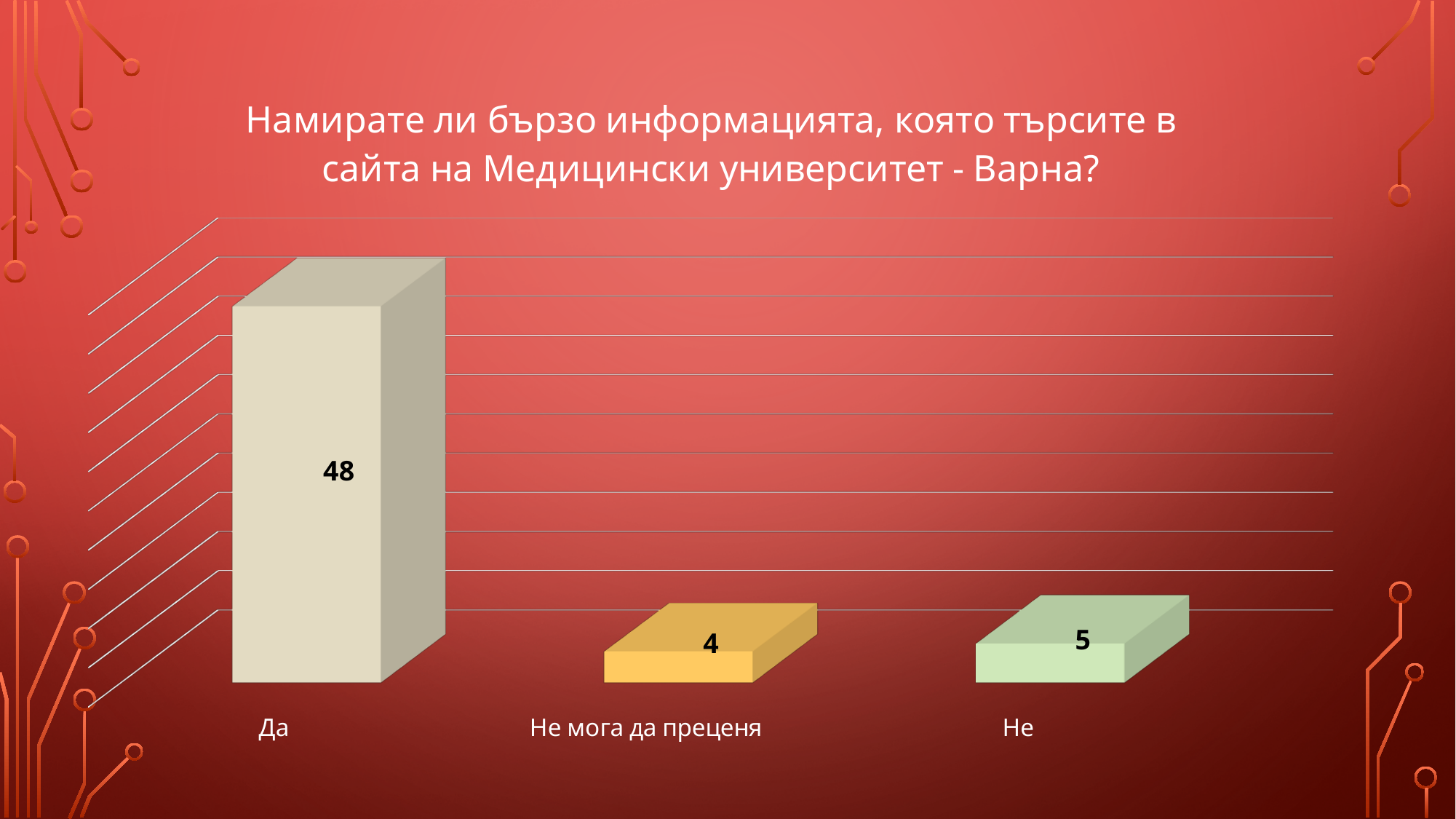
What is the difference between the values for "Не" and "Не мога да преценя"? 1 How many categories are shown in the chart? 3 Which category has the lowest value? Не мога да преценя What is the value for "Да"? 48 What kind of chart is shown on the slide? bar chart What is the difference between the values for "Да" and "Не"? 43 What is the title of the chart? Намирате ли бързо информацията, която търсите в сайта на Медицински университет - Варна? What is the value for "Не мога да преценя"? 4 What is the total of the three values shown in the chart? 57 Which category has the highest value? Да Which is larger, the value for "Да" or the value for "Не"? Да What is the value for "Не"? 5